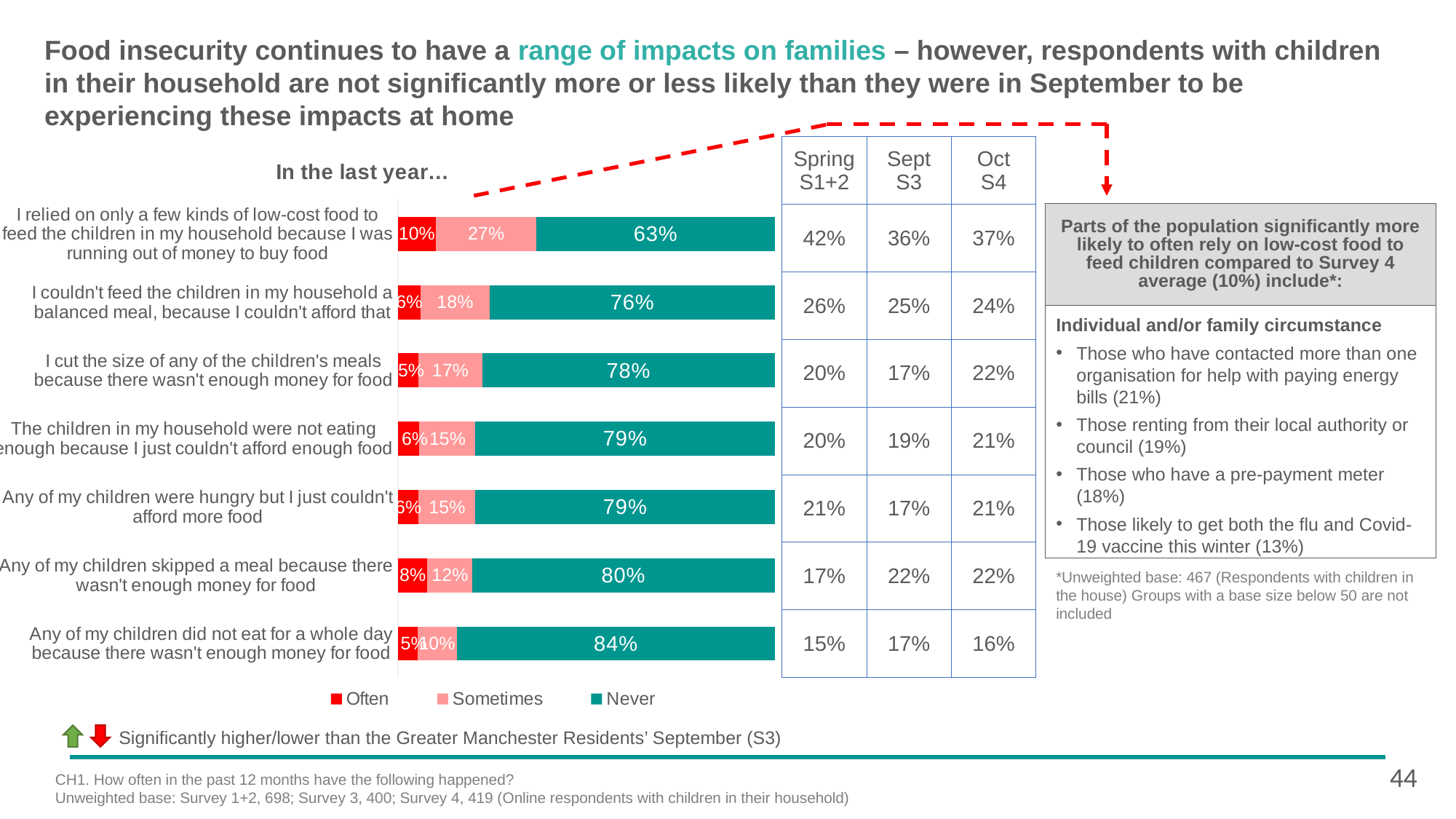
Which is larger: the 'Often' value for 'I relied on only a few kinds of low-cost food...' or the 'Often' value for 'Any of my children skipped a meal...'? I relied on only a few kinds of low-cost food... How many series does the chart legend list? 3 What is the 'Sometimes' value for 'I couldn't feed the children in my household a balanced meal, because I couldn't afford that'? 18% What kind of chart is shown on the slide? Stacked bar chart Which legend entry is shown in dark teal? Never Which statement has the highest 'Never' value? Any of my children did not eat for a whole day because there wasn't enough money for food Which statement has the lowest 'Never' value? I relied on only a few kinds of low-cost food to feed the children in my household because I was running out of money to buy food What is the combined 'Often' and 'Sometimes' share for 'I cut the size of any of the children's meals because there wasn't enough money for food'? 22% What is the 'Often' value for 'Any of my children skipped a meal because there wasn't enough money for food'? 8% What is the 'Never' value for 'I relied on only a few kinds of low-cost food to feed the children in my household because I was running out of money to buy food'? 63% What is the difference between the 'Sometimes' values for 'I relied on only a few kinds of low-cost food...' and 'Any of my children did not eat for a whole day...'? 17% How many categories (statements) are plotted in the chart? 7